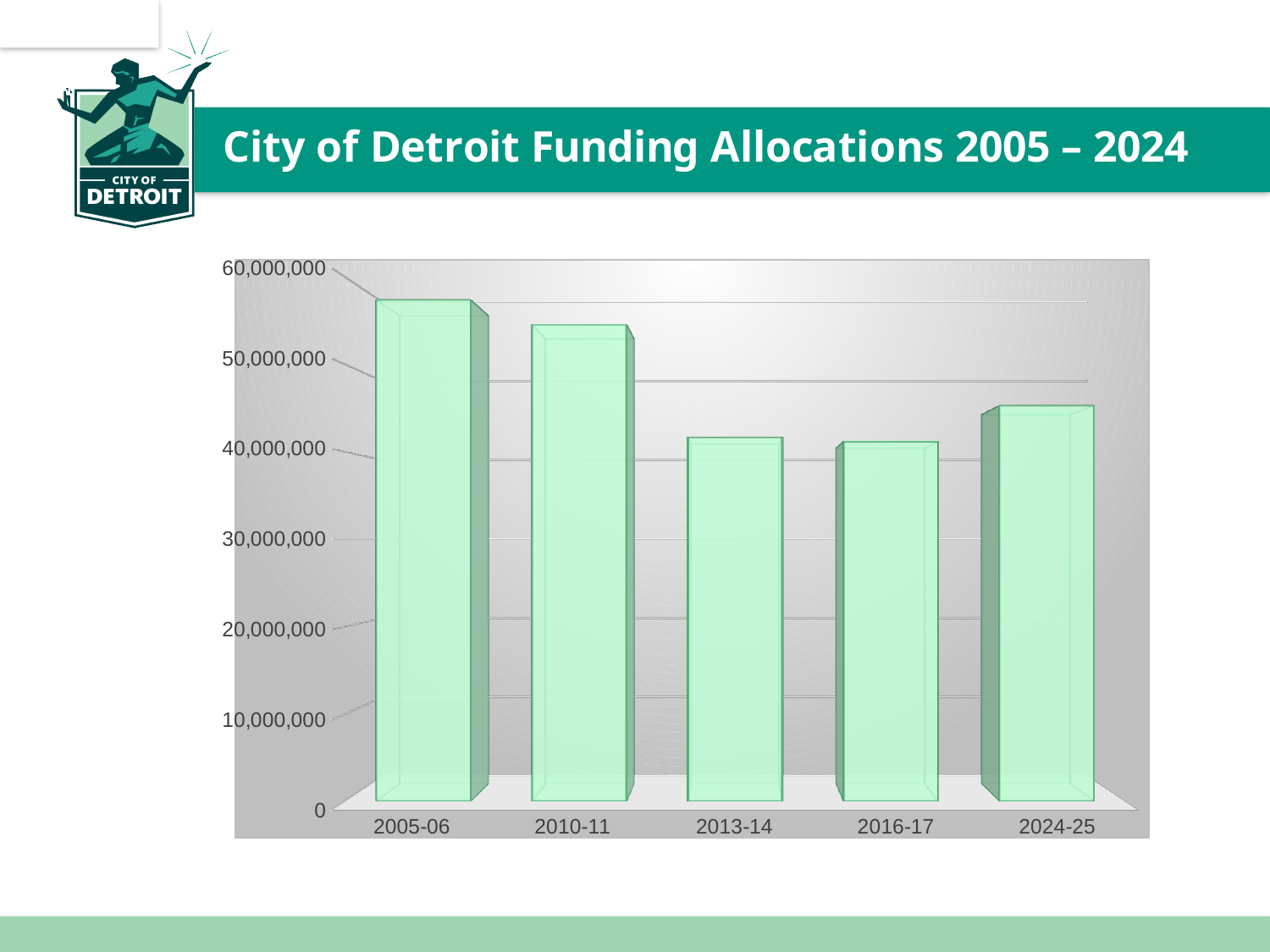
Is the value for 2005-06 greater or less than 50,000,000? greater How many categories (fiscal years) are shown on the x axis? 5 What kind of chart is shown on the slide? bar chart Which is larger, the value for 2024-25 or the value for 2016-17? 2024-25 Is the value for 2024-25 greater or less than 40,000,000? greater What is the title shown above the chart? City of Detroit Funding Allocations 2005 – 2024 Which is larger, the value for 2005-06 or the value for 2010-11? 2005-06 Is the value for 2013-14 greater or less than 50,000,000? less Do the values rise or fall from 2005-06 to 2016-17? fall Which fiscal year has the highest funding allocation? 2005-06